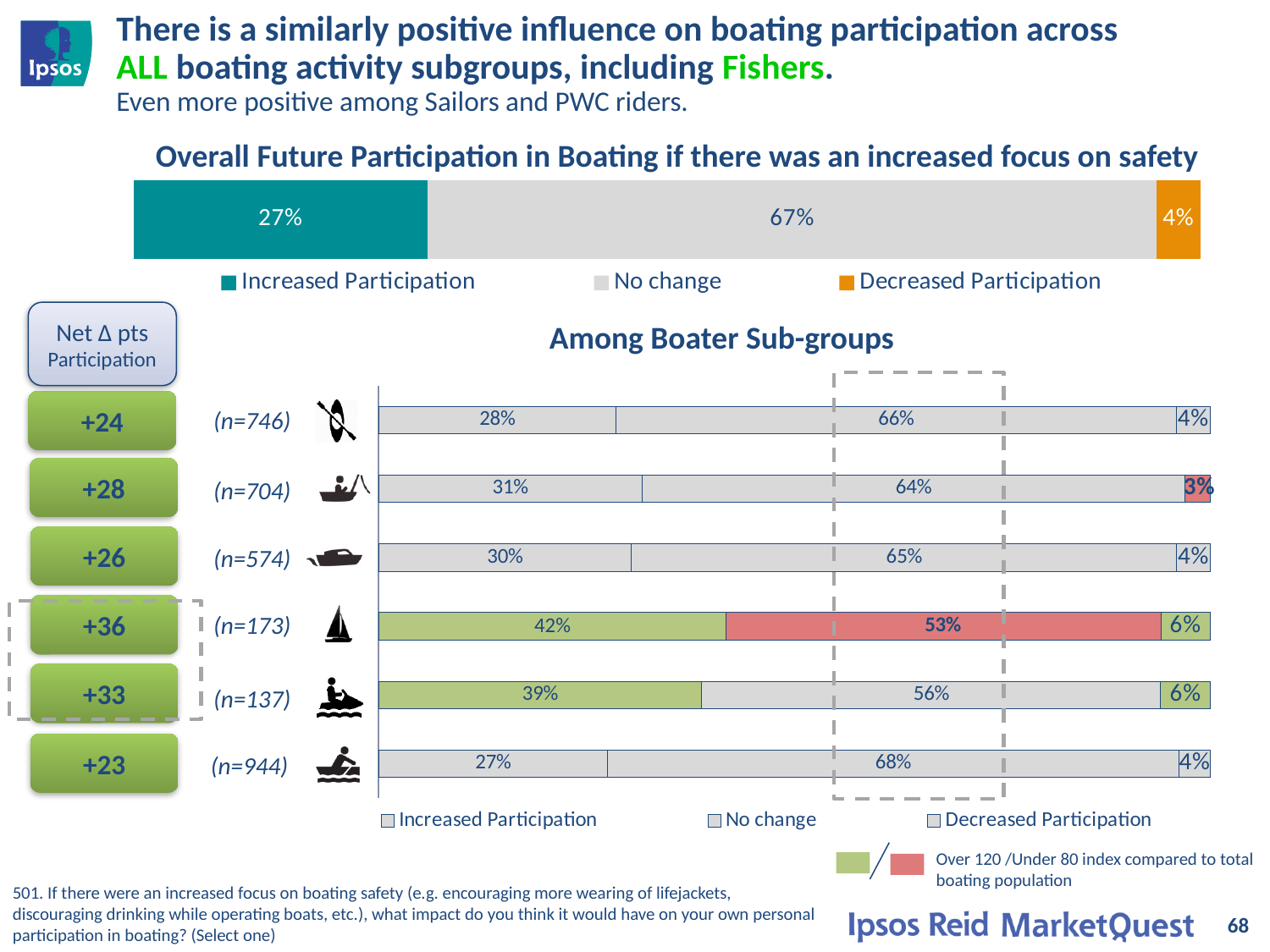
In the 'Among Boater Sub-groups' chart, how many sub-group bars are plotted? 6 In the top chart 'Overall Future Participation in Boating if there was an increased focus on safety', what percentage is shown for No change? 67% What kind of chart is the 'Among Boater Sub-groups' chart? Stacked bar chart In the 'Among Boater Sub-groups' chart, what is the difference between the Increased Participation values for the n=173 and n=137 sub-groups? 3 percentage points In the 'Among Boater Sub-groups' chart, what is the Increased Participation value for the sub-group with n=173? 42% In the 'Among Boater Sub-groups' chart, what is the No change value for the sub-group with n=137? 56% How many series does the legend of the top chart 'Overall Future Participation in Boating' list? 3 In the top chart 'Overall Future Participation in Boating if there was an increased focus on safety', what percentage is shown for Increased Participation? 27% In the 'Among Boater Sub-groups' chart, which sub-group (by n) has the lowest Increased Participation value? n=944 In the 'Among Boater Sub-groups' chart, which sub-group (by n) has the highest Increased Participation value? n=173 In the top chart 'Overall Future Participation in Boating if there was an increased focus on safety', what percentage is shown for Decreased Participation? 4% In the 'Among Boater Sub-groups' chart, which is larger: the Decreased Participation value for n=704 or for n=173? n=173